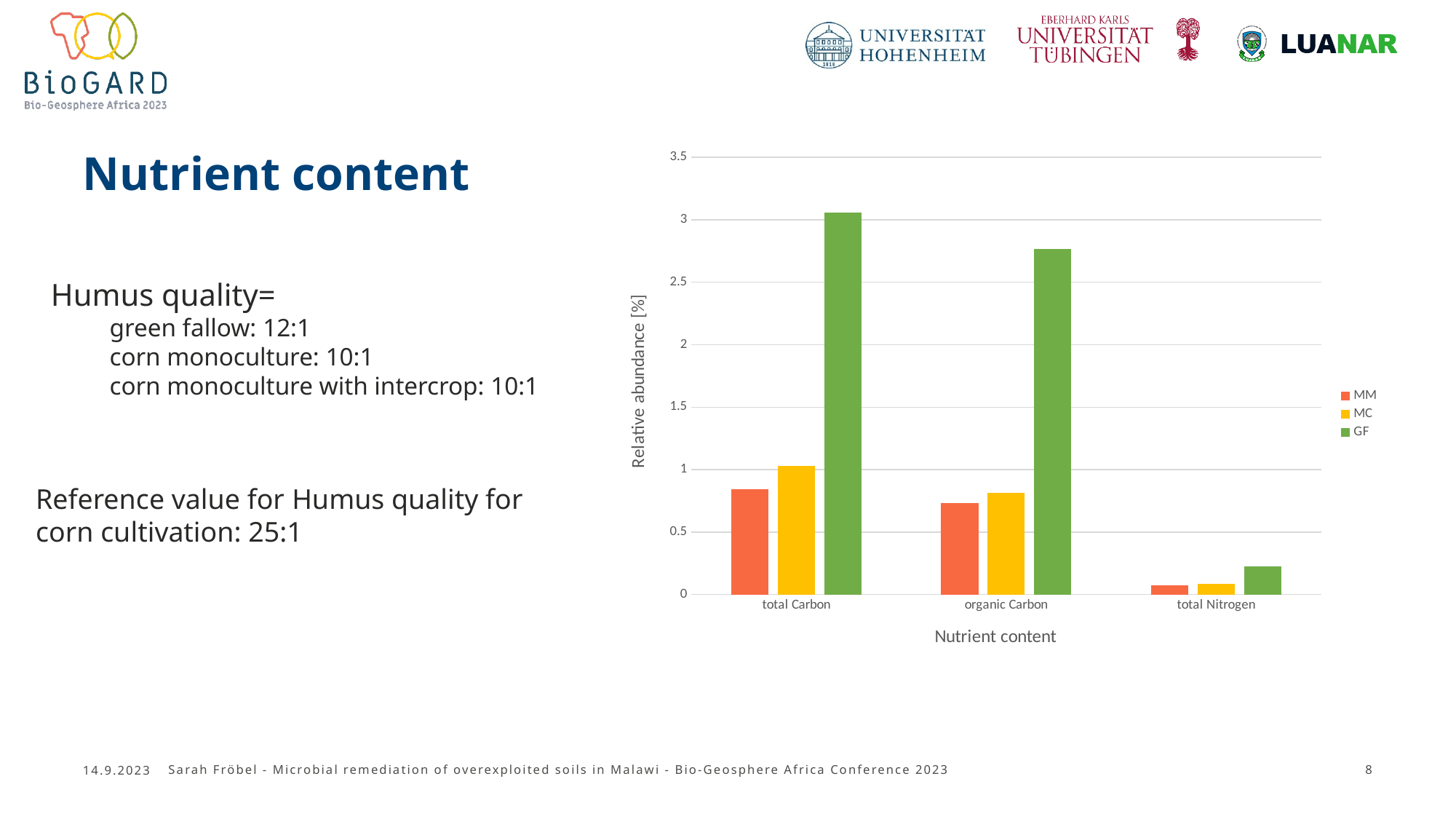
Is the GF value for organic Carbon greater or less than 3? less Is the GF value for total Nitrogen greater or less than 0.5? less Is the GF value for total Carbon greater or less than 2.5? greater What kind of chart is shown on the slide? bar chart Which is larger for GF: the total Carbon bar or the organic Carbon bar? total Carbon How many categories are shown on the x axis of the chart? 3 Which category has the lowest bars overall in the chart? total Nitrogen How many series does the chart legend list? 3 Which is larger for total Carbon: the MM bar or the MC bar? MC Which series has the highest bar for total Carbon? GF What is the label of the y axis of the chart? Relative abundance [%]